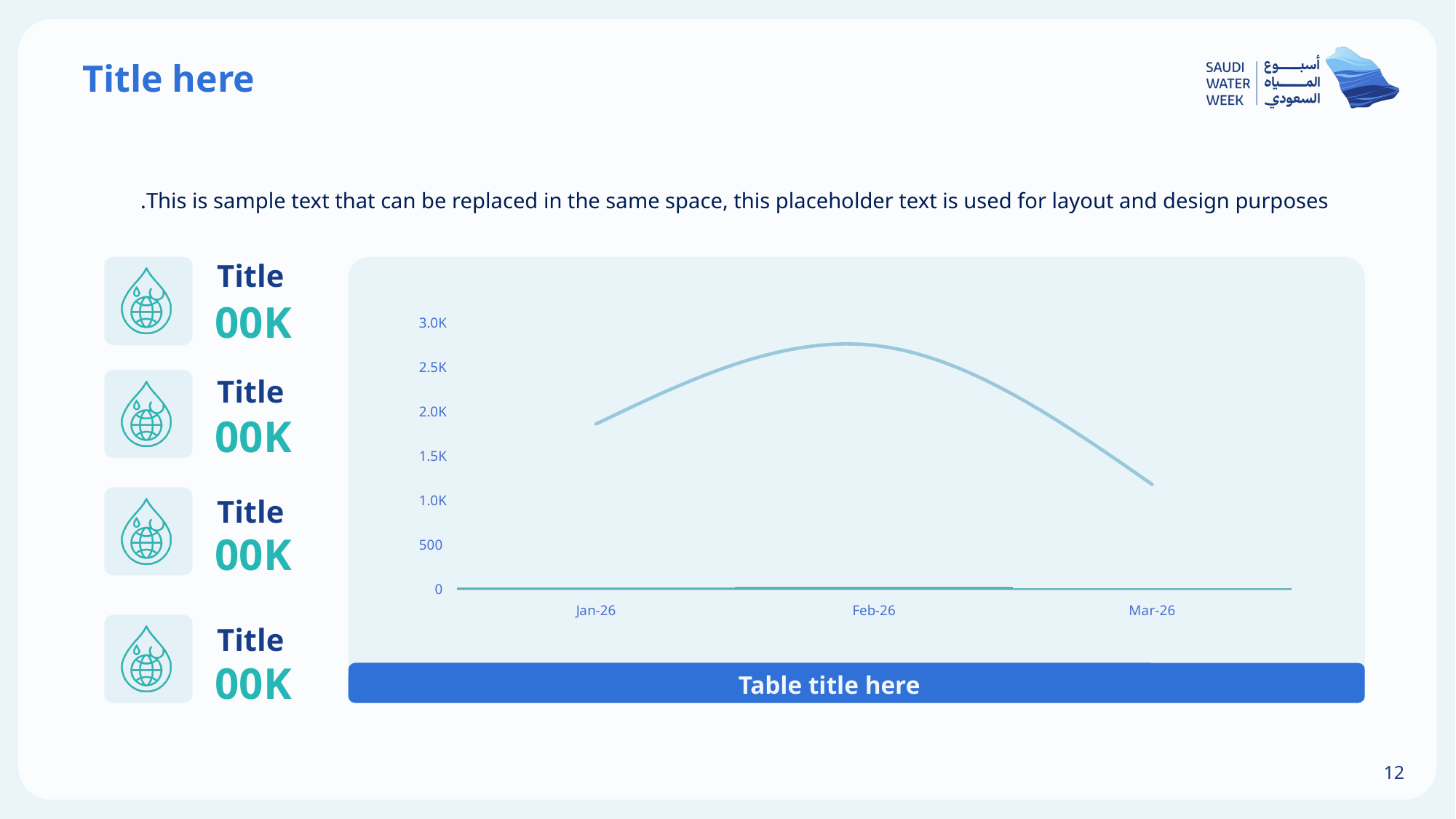
Which is larger, the value for Jan-26 or the value for Mar-26? Jan-26 What kind of chart is shown on the slide? line chart Is the value for Jan-26 greater or less than 1.5K? greater Does the line rise or fall from Feb-26 to Mar-26? fall Which is larger, the value for Feb-26 or the value for Jan-26? Feb-26 How many points are plotted on the line chart? 3 Which month has the highest value on the line chart? Feb-26 Which month has the lowest value on the line chart? Mar-26 What is the title shown in the blue bar beneath the chart? Table title here Does the line rise or fall from Jan-26 to Feb-26? rise Is the value for Mar-26 greater or less than 1.5K? less Is the value for Feb-26 greater or less than 2.5K? greater